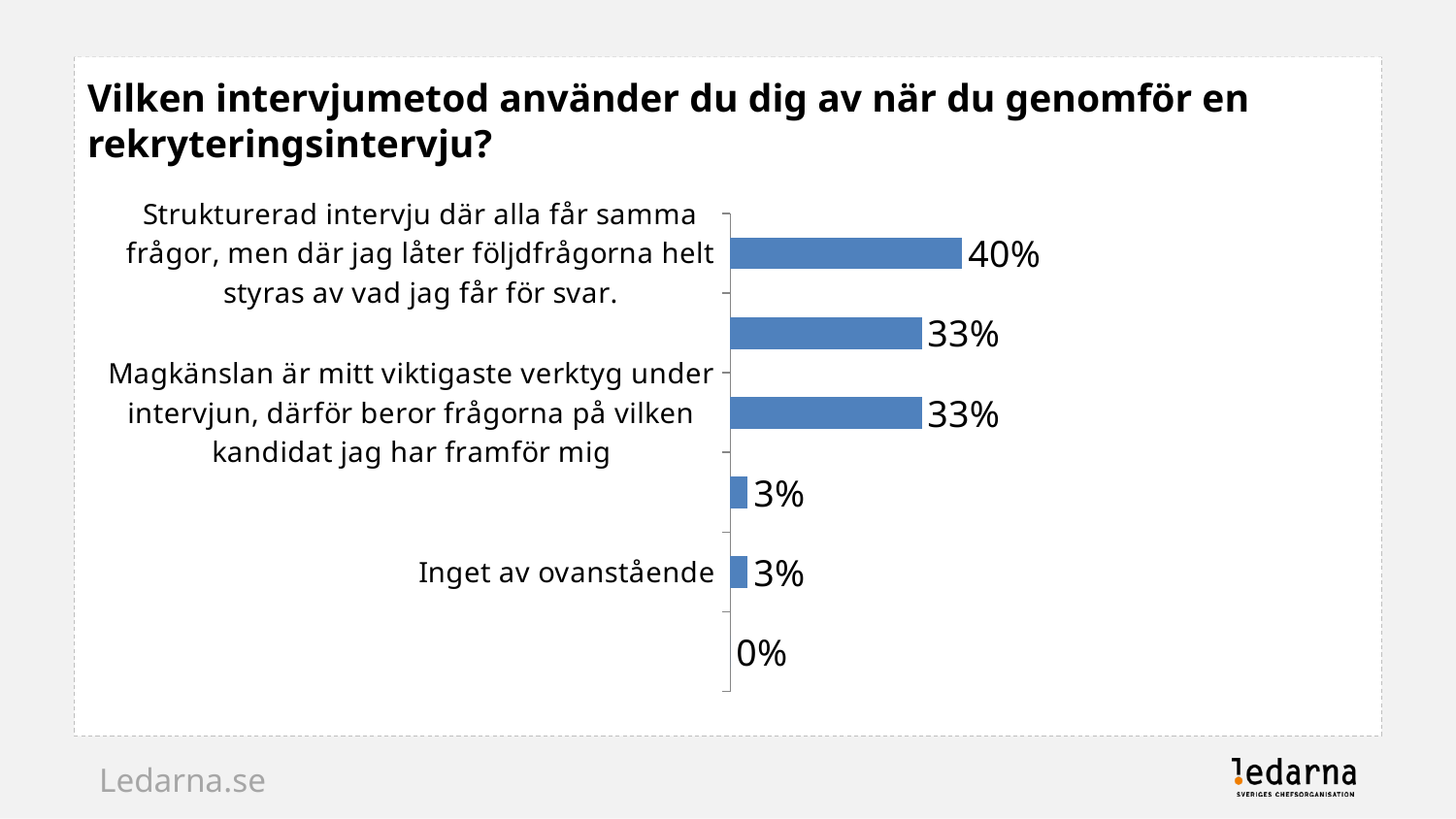
What kind of chart is shown on the slide? Bar chart What is the value for "Inget av ovanstående"? 3% Which category has the highest value? Strukturerad intervju där alla får samma frågor, men där jag låter följdfrågorna helt styras av vad jag får för svar. How many bars are plotted in the chart? 6 What is the value for "Magkänslan är mitt viktigaste verktyg under intervjun, därför beror frågorna på vilken kandidat jag har framför mig"? 33% How many bars have a value of 33%? 2 Which is larger: the value for "Magkänslan är mitt viktigaste verktyg..." or the value for "Inget av ovanstående"? Magkänslan är mitt viktigaste verktyg under intervjun, därför beror frågorna på vilken kandidat jag har framför mig What is the highest value shown in the chart? 40% What is the value for "Strukturerad intervju där alla får samma frågor, men där jag låter följdfrågorna helt styras av vad jag får för svar."? 40% What is the title of the slide? Vilken intervjumetod använder du dig av när du genomför en rekryteringsintervju? What is the difference between the value for "Strukturerad intervju..." and the value for "Magkänslan är mitt viktigaste verktyg..."? 7 percentage points What is the lowest value shown in the chart? 0%